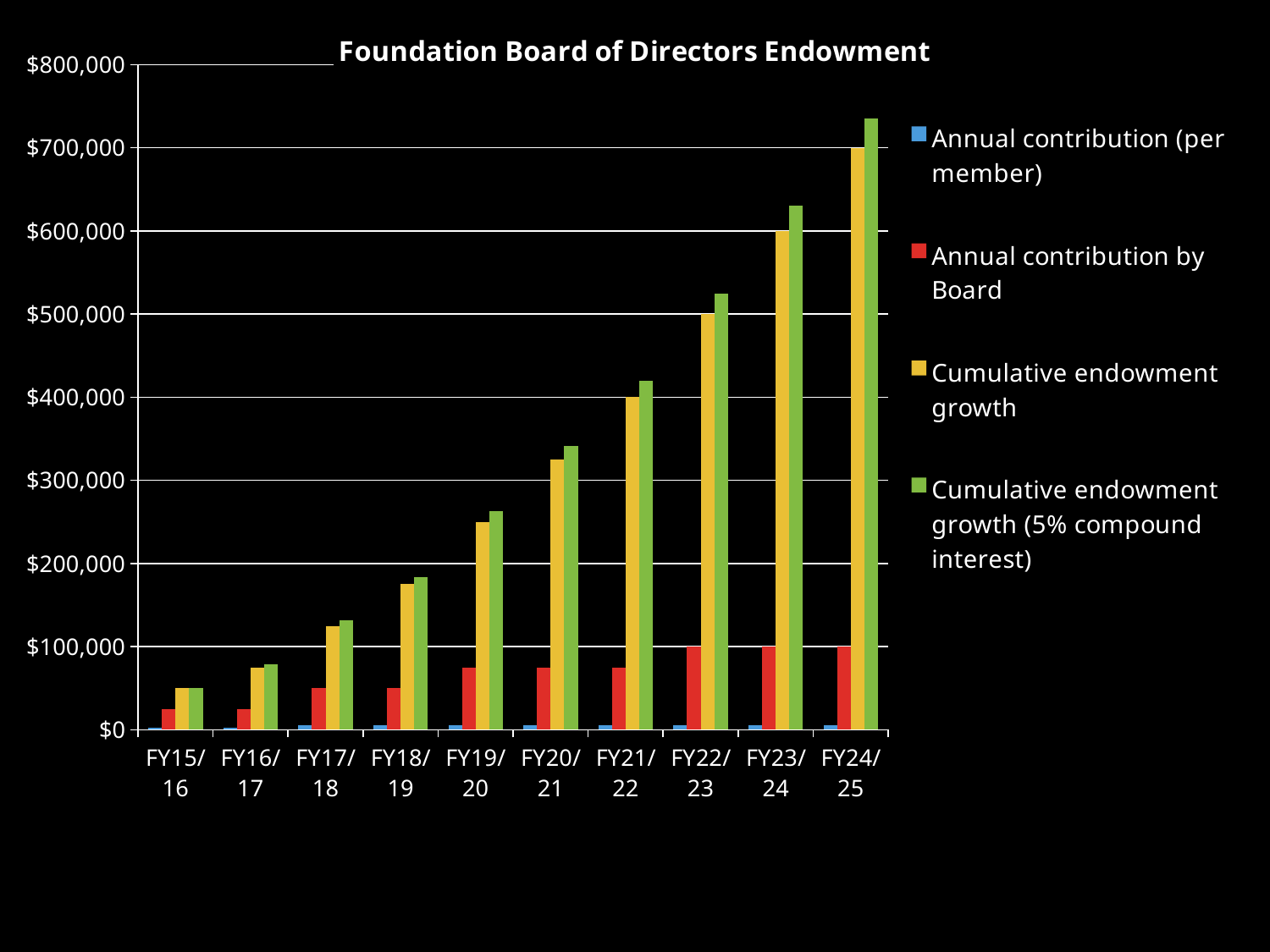
In which fiscal year is Cumulative endowment growth lowest? FY15/16 Is the value of Cumulative endowment growth (5% compound interest) for FY24/25 greater or less than $700,000? greater What is the value of Cumulative endowment growth for FY22/23? $500,000 What is the title of the chart? Foundation Board of Directors Endowment What is the Annual contribution by Board for FY23/24? $100,000 How many fiscal years are shown on the x axis? 10 Does Cumulative endowment growth rise or fall from FY15/16 to FY24/25? rise In which fiscal year is Cumulative endowment growth (5% compound interest) highest? FY24/25 How many series does the legend list? 4 What is the value of Cumulative endowment growth for FY24/25? $700,000 Is the value of Cumulative endowment growth for FY19/20 greater or less than $300,000? less What kind of chart is shown on the slide? bar chart